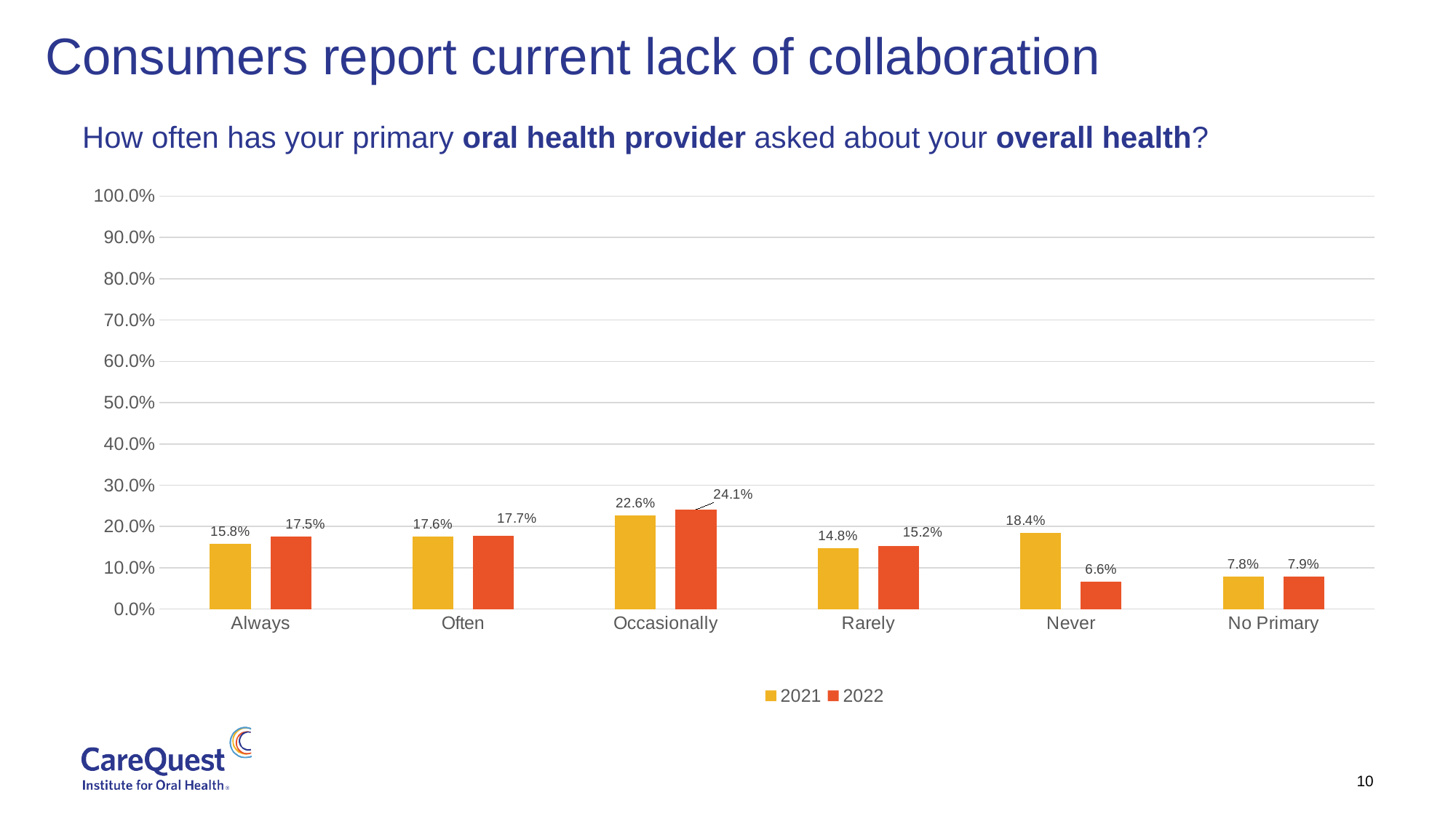
What is the 2021 value for Never? 18.4% How many series does the legend list? 2 Which category has the highest 2021 value? Occasionally Which is larger for Always: the 2021 value or the 2022 value? 2022 Which category has the lowest 2022 value? Never Is the 2022 value for Occasionally greater or less than 20.0%? greater How many categories are shown on the x axis? 6 What is the 2022 value for Occasionally? 24.1% What is the 2022 value for No Primary? 7.9% Which colour represents the 2021 series in the legend? yellow What kind of chart is shown on the slide? bar chart What is the difference between the 2021 and 2022 values for Never? 11.8%